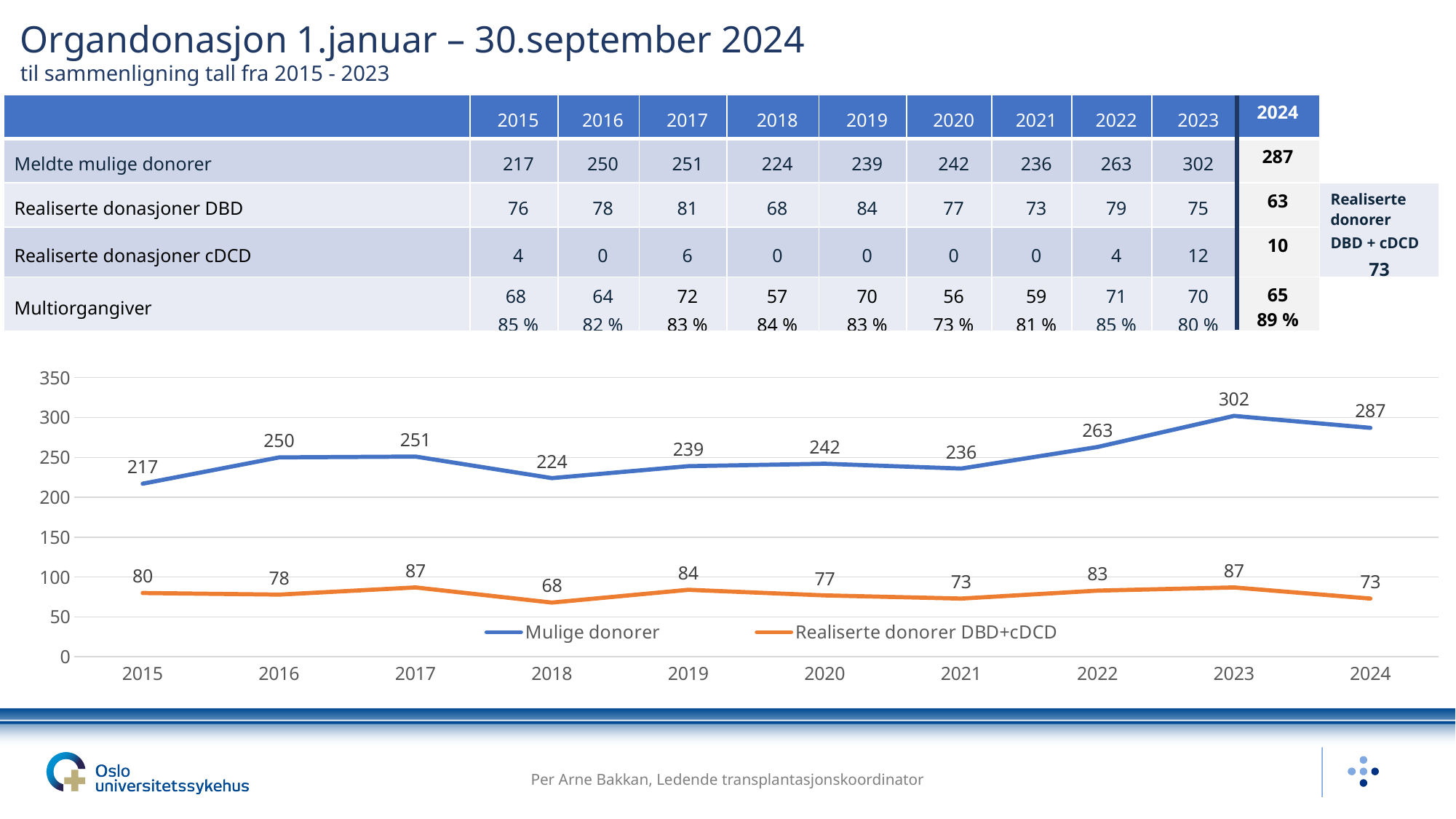
What is the value for Mulige donorer in 2024? 287 Which series is drawn in orange in the chart? Realiserte donorer DBD+cDCD What is the value for Realiserte donorer DBD+cDCD in 2018? 68 In which year is Mulige donorer highest? 2023 In which year is Mulige donorer lowest? 2015 What is the difference between Mulige donorer in 2023 and in 2024? 15 Which is larger: Realiserte donorer DBD+cDCD in 2019 or in 2020? 2019 How many series does the chart legend list? 2 What is the value for Mulige donorer in 2023? 302 In which year is Realiserte donorer DBD+cDCD lowest? 2018 What type of chart is shown on the slide? Line chart How many years are plotted along the x axis of the chart? 10